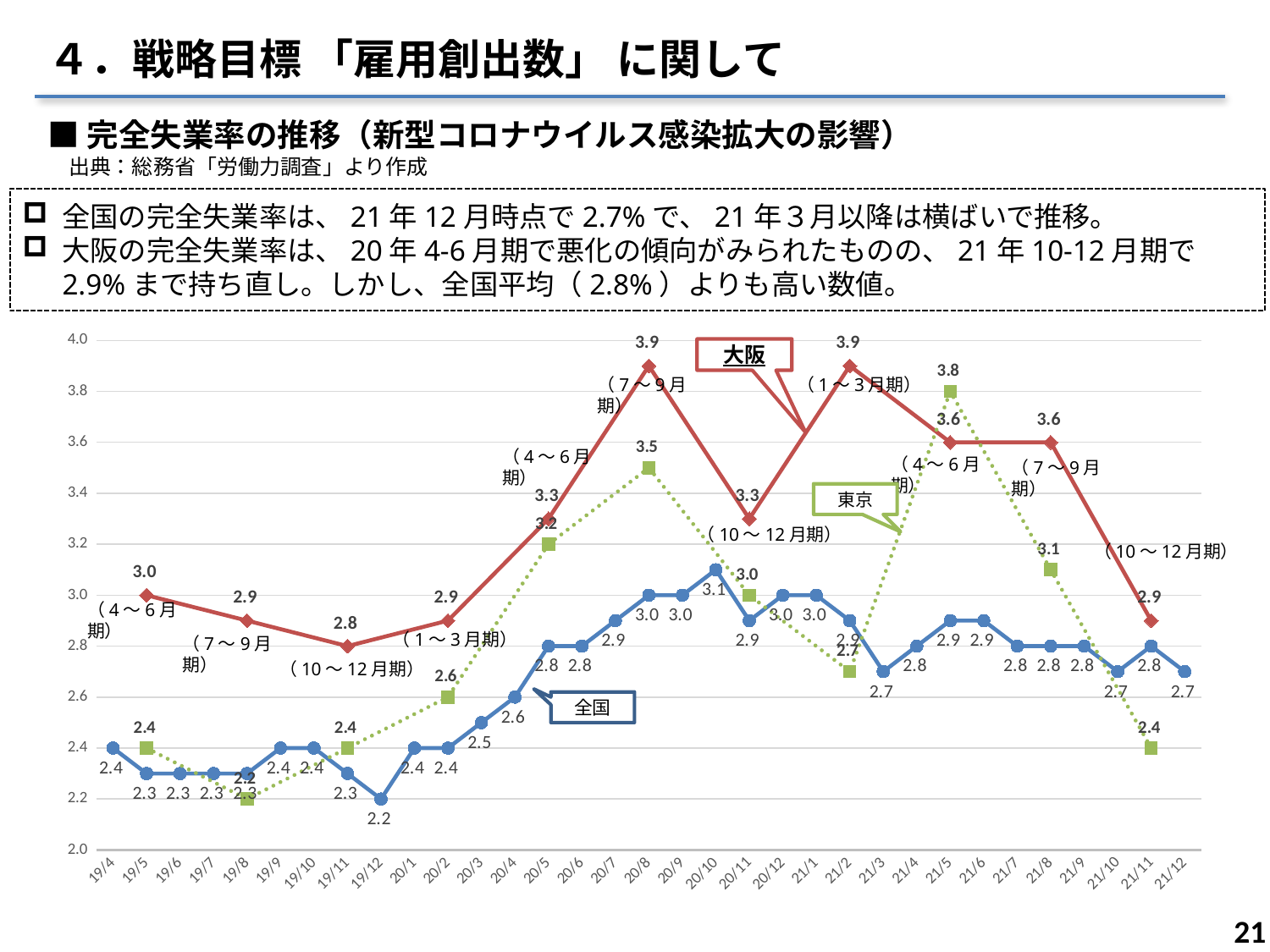
What type of chart is shown on the slide? line chart Does the 全国 series rise or fall from 20/2 to 20/10? rise What is the value for 大阪 at 20/8? 3.9 What is the difference between the 大阪 value and the 全国 value at 21/11? 0.1 At which x-axis point does the 全国 series reach its highest value? 20/10 What is the value for 東京 at 21/5? 3.8 At 20/8, which series has the larger value, 大阪 or 東京? 大阪 At which x-axis point does the 大阪 series reach its lowest value? 19/11 How many data series are plotted in the chart (大阪, 東京, 全国)? 3 How many monthly points are shown on the x axis from 19/4 to 21/12? 33 At which x-axis point does the 東京 series reach its lowest value? 19/8 What is the value for 全国 at 21/12? 2.7